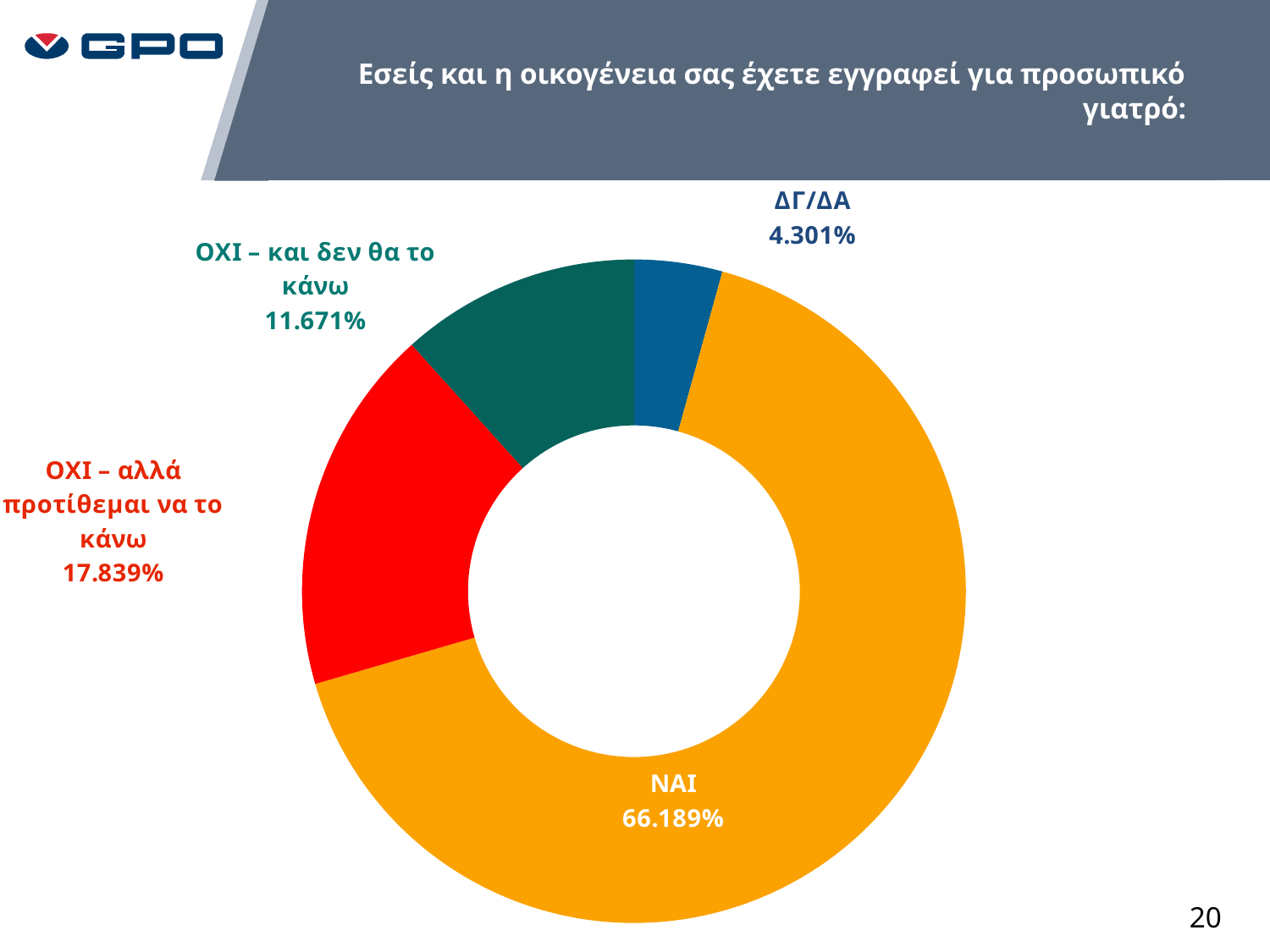
Which category has the largest share of the chart? ΝΑΙ What percentage answered 'ΟΧΙ – αλλά προτίθεμαι να το κάνω'? 17.839% What percentage answered 'ΟΧΙ – και δεν θα το κάνω'? 11.671% What kind of chart is shown on the slide? Doughnut (pie) chart What percentage of respondents answered ΝΑΙ? 66.189% How many categories are shown in the chart? 4 What is the value for the ΔΓ/ΔΑ slice? 4.301% What colour is the ΝΑΙ slice? Orange Which category has the smallest share of the chart? ΔΓ/ΔΑ Which is larger: the share for 'ΟΧΙ – και δεν θα το κάνω' or the share for ΔΓ/ΔΑ? ΟΧΙ – και δεν θα το κάνω What is the combined share of the two ΟΧΙ categories? 29.510% What is the difference in percentage points between 'ΟΧΙ – αλλά προτίθεμαι να το κάνω' and 'ΟΧΙ – και δεν θα το κάνω'? 6.168